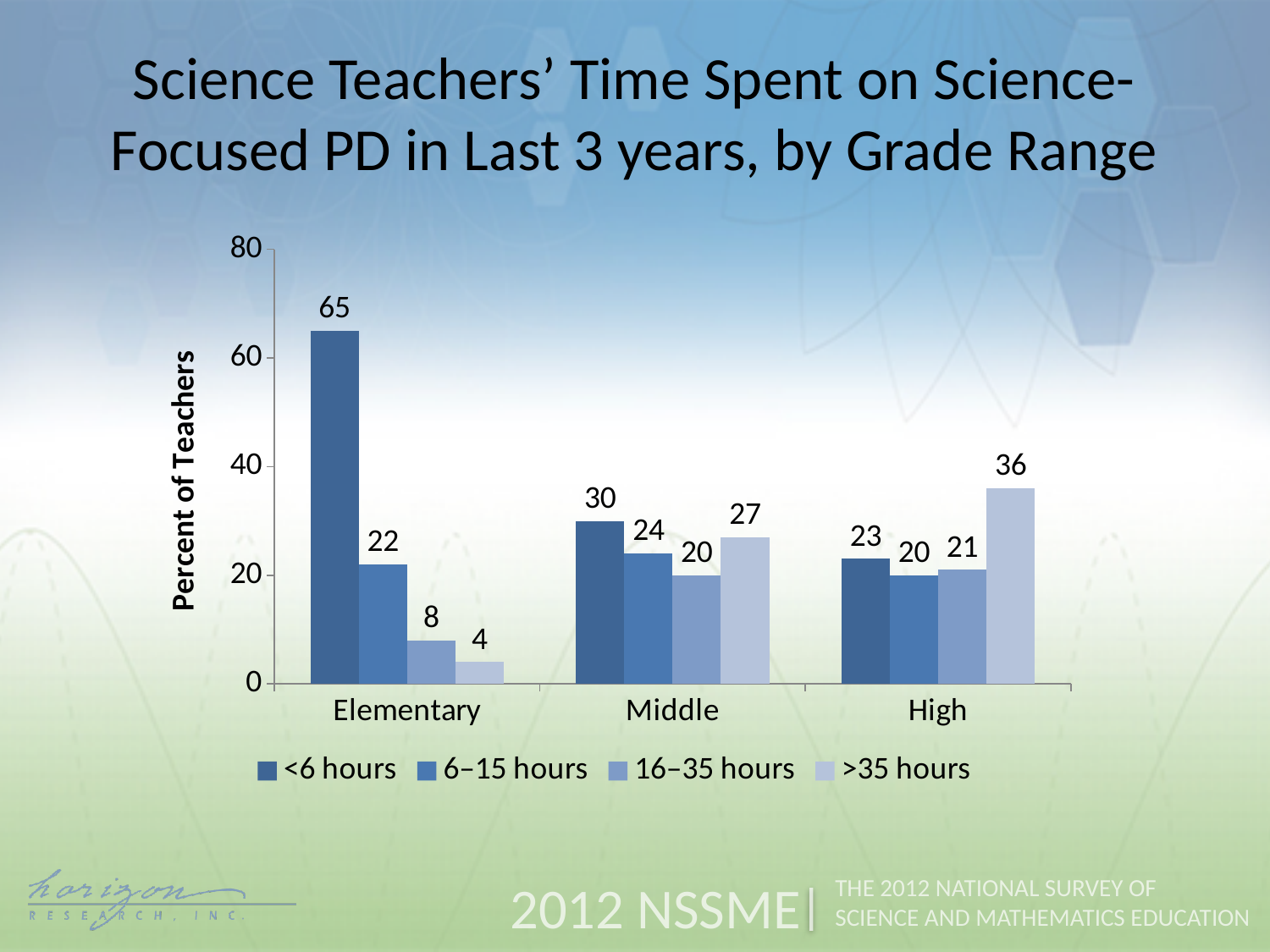
Does the >35 hours value rise or fall from Elementary to High? Rise Which is larger for the High grade range: the <6 hours value or the >35 hours value? >35 hours What percent of elementary science teachers spent <6 hours on science-focused PD? 65 How many series does the legend list? 4 What is the difference between the <6 hours and 6–15 hours values for Elementary? 43 Which grade range has the lowest value for the >35 hours series? Elementary How many grade ranges are shown on the x axis? 3 What kind of chart is shown on the slide? Bar chart What is the label on the y axis? Percent of Teachers What is the value for 16–35 hours in the Middle grade range? 20 What is the value for >35 hours in the High grade range? 36 Which grade range has the highest value for the <6 hours series? Elementary